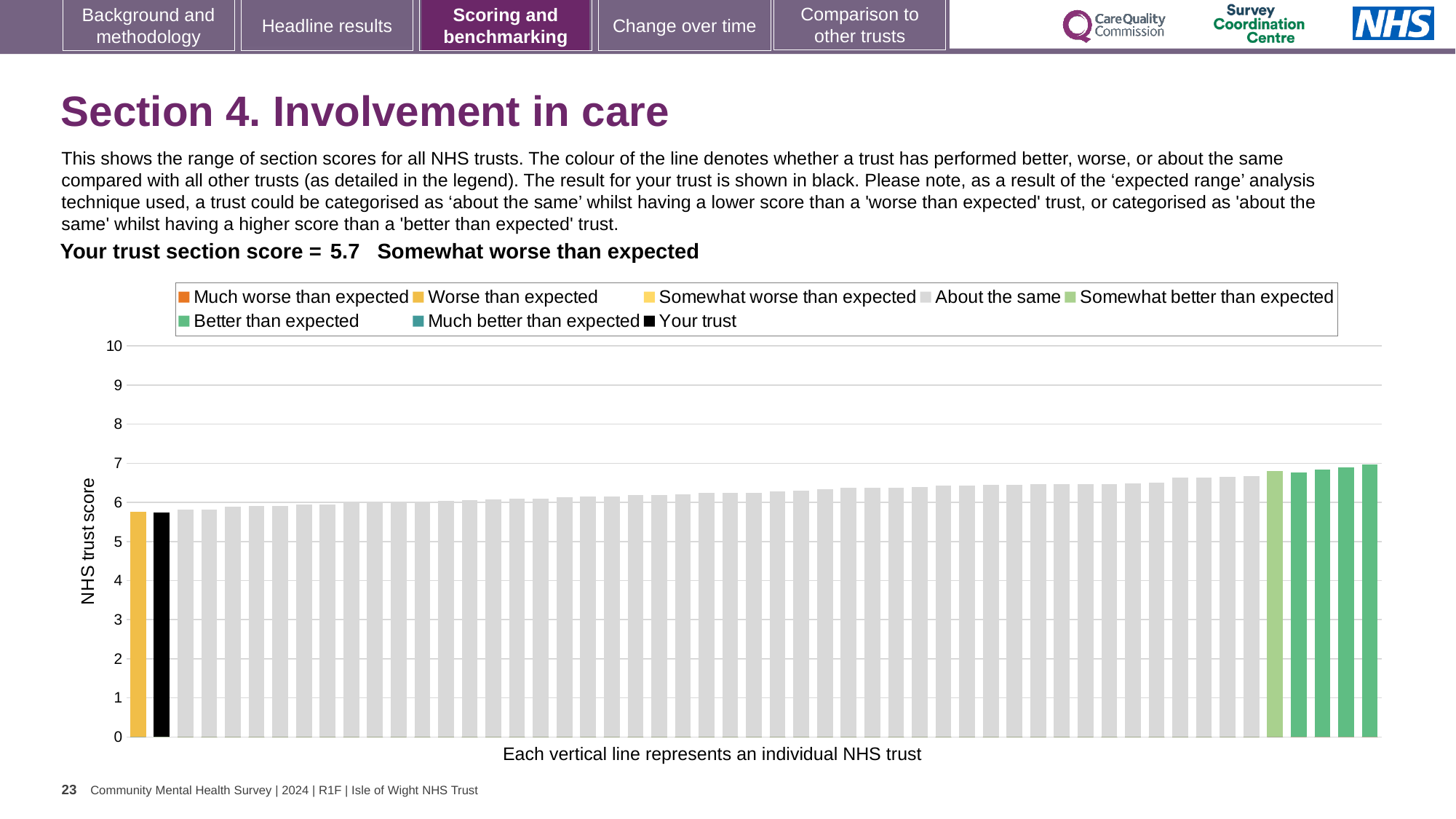
How many entries does the chart legend list? 8 Is the value of the shortest bar greater or less than 5? greater Which is larger, the leftmost bar or the rightmost bar? The rightmost bar Do the bar values rise or fall from left to right along the x axis? Rise Which performance category is your trust's section score assigned to? Somewhat worse than expected What colour is the bar representing your trust? Black What is the section score for your trust shown on the slide? 5.7 What is the highest value shown on the y axis? 10 What kind of chart is shown on the slide? Bar chart Is the value of the tallest bar greater or less than 6? greater Is the value of the black 'Your trust' bar greater or less than 6? less